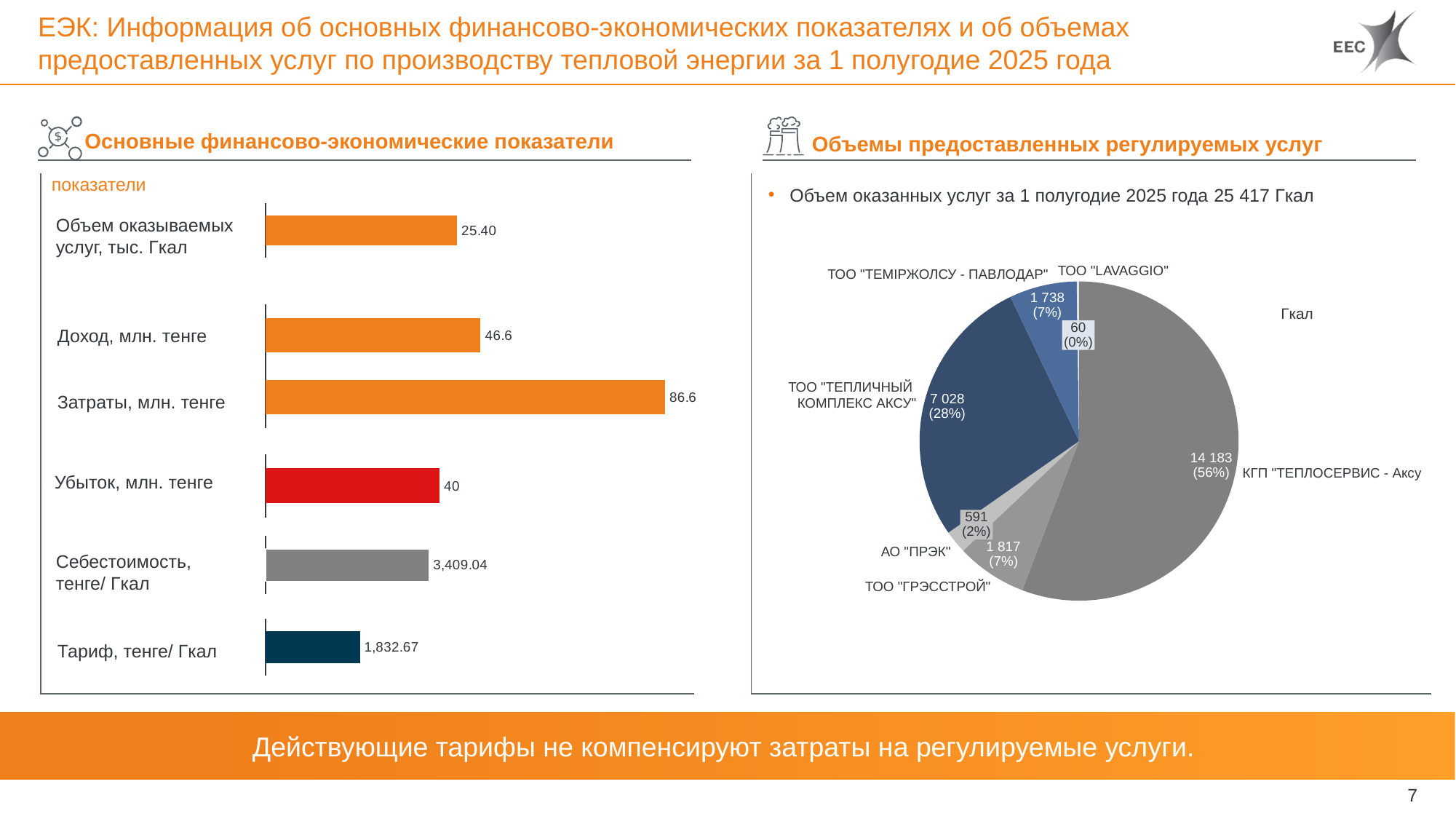
On the right pie chart (Объемы предоставленных регулируемых услуг), which category has the smallest share? ТОО "LAVAGGIO" On the left chart (Основные финансово-экономические показатели), how many categories are plotted? 6 On the left chart (Основные финансово-экономические показатели), which is larger: Себестоимость, тенге/ Гкал or Тариф, тенге/ Гкал? Себестоимость, тенге/ Гкал On the left chart (Основные финансово-экономические показатели), what is the value for Доход, млн. тенге? 46.6 On the right pie chart (Объемы предоставленных регулируемых услуг), what share does АО "ПРЭК" have? 2% On the left chart (Основные финансово-экономические показатели), what is the value for Тариф, тенге/ Гкал? 1,832.67 On the right pie chart (Объемы предоставленных регулируемых услуг), what is the value for ТОО "ТЕПЛИЧНЫЙ КОМПЛЕКС АКСУ"? 7 028 On the right pie chart (Объемы предоставленных регулируемых услуг), which category has the largest share? КГП "ТЕПЛОСЕРВИС - Аксу" On the left chart (Основные финансово-экономические показатели), what is the difference between Затраты, млн. тенге and Доход, млн. тенге? 40 On the right pie chart (Объемы предоставленных регулируемых услуг), how many slices are there? 6 What kind of chart is shown on the left side of the slide (Основные финансово-экономические показатели)? Bar chart On the left chart (Основные финансово-экономические показатели), what is the value for Себестоимость, тенге/ Гкал? 3,409.04